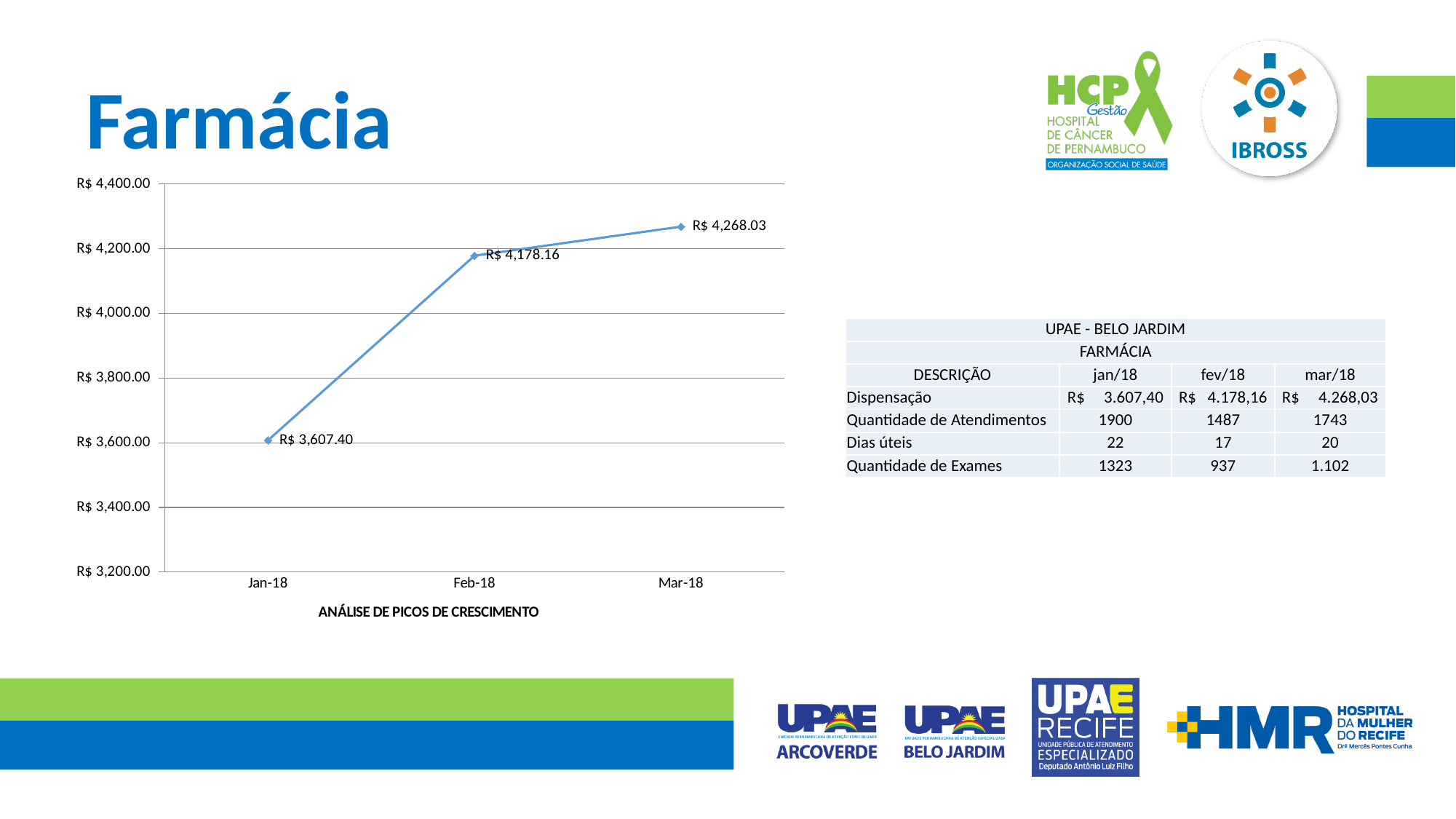
What is the value plotted for Mar-18? R$ 4,268.03 How many data points are plotted on the chart? 3 What is the value plotted for Jan-18? R$ 3,607.40 Do the values rise or fall from Jan-18 to Mar-18? rise Which month has the lowest value on the chart? Jan-18 What is the difference between the Mar-18 and Feb-18 values? R$ 89.87 Which is larger, the value for Jan-18 or the value for Feb-18? Feb-18 What is the value plotted for Feb-18? R$ 4,178.16 What kind of chart is shown on the slide? line chart Is the value for Jan-18 greater or less than R$ 3,800.00? less What is the difference between the Feb-18 and Jan-18 values? R$ 570.76 Which month has the highest value on the chart? Mar-18